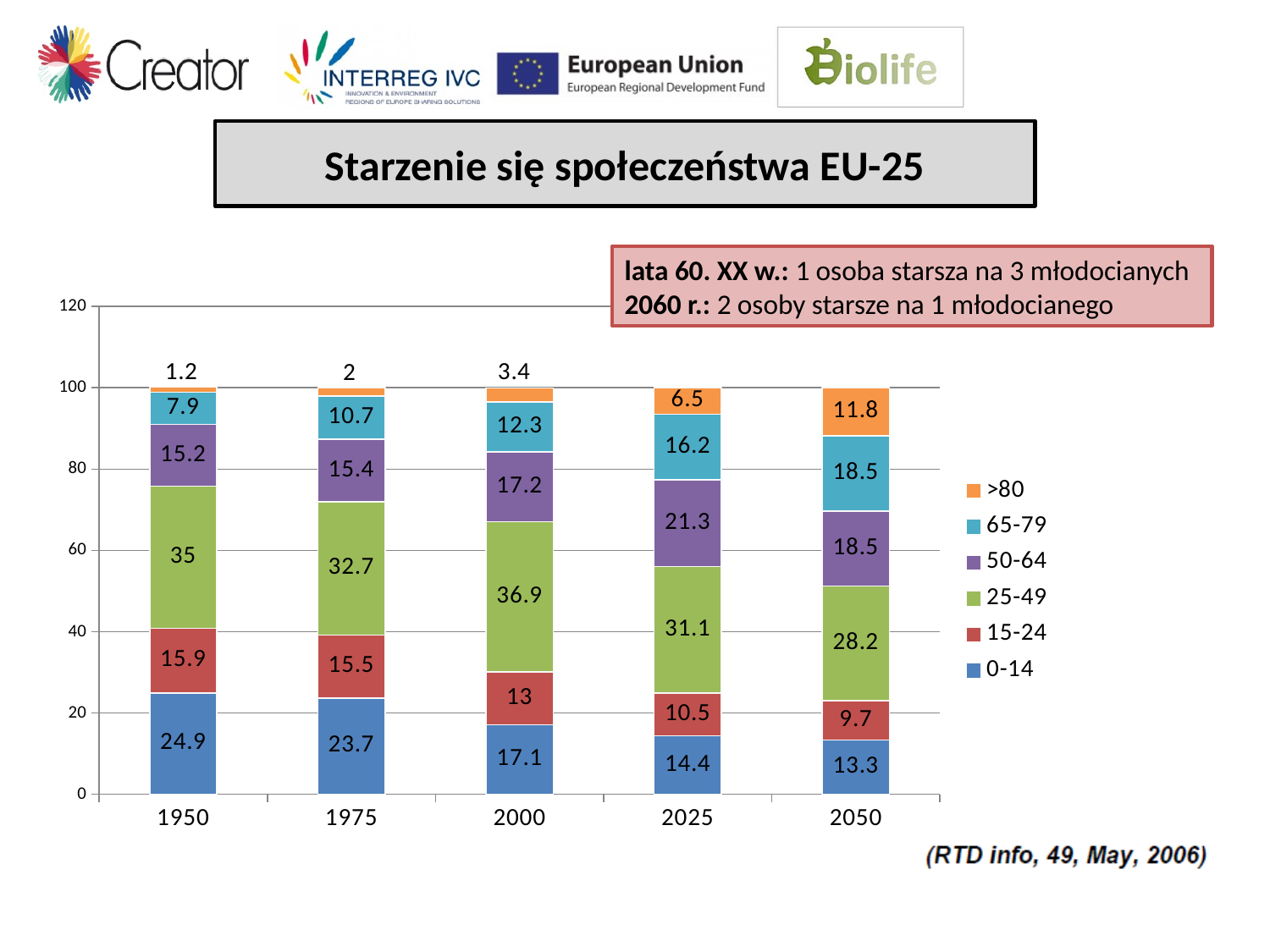
What is the value for the 25-49 age group in 2000? 36.9 How many series does the legend list? 6 What is the value for the 0-14 age group in 1950? 24.9 Which is larger, the 50-64 value in 2025 or the 50-64 value in 2050? 2025 What is the difference between the 0-14 values for 1950 and 2050? 11.6 What is the value for the >80 age group in 2050? 11.8 In which year is the >80 age group value the lowest? 1950 Does the 0-14 age group value rise or fall from 1950 to 2050? Fall How many years are shown on the x axis? 5 What is the value for the 65-79 age group in 2025? 16.2 What kind of chart is shown on the slide? Stacked bar chart In which year is the 0-14 age group value the highest? 1950